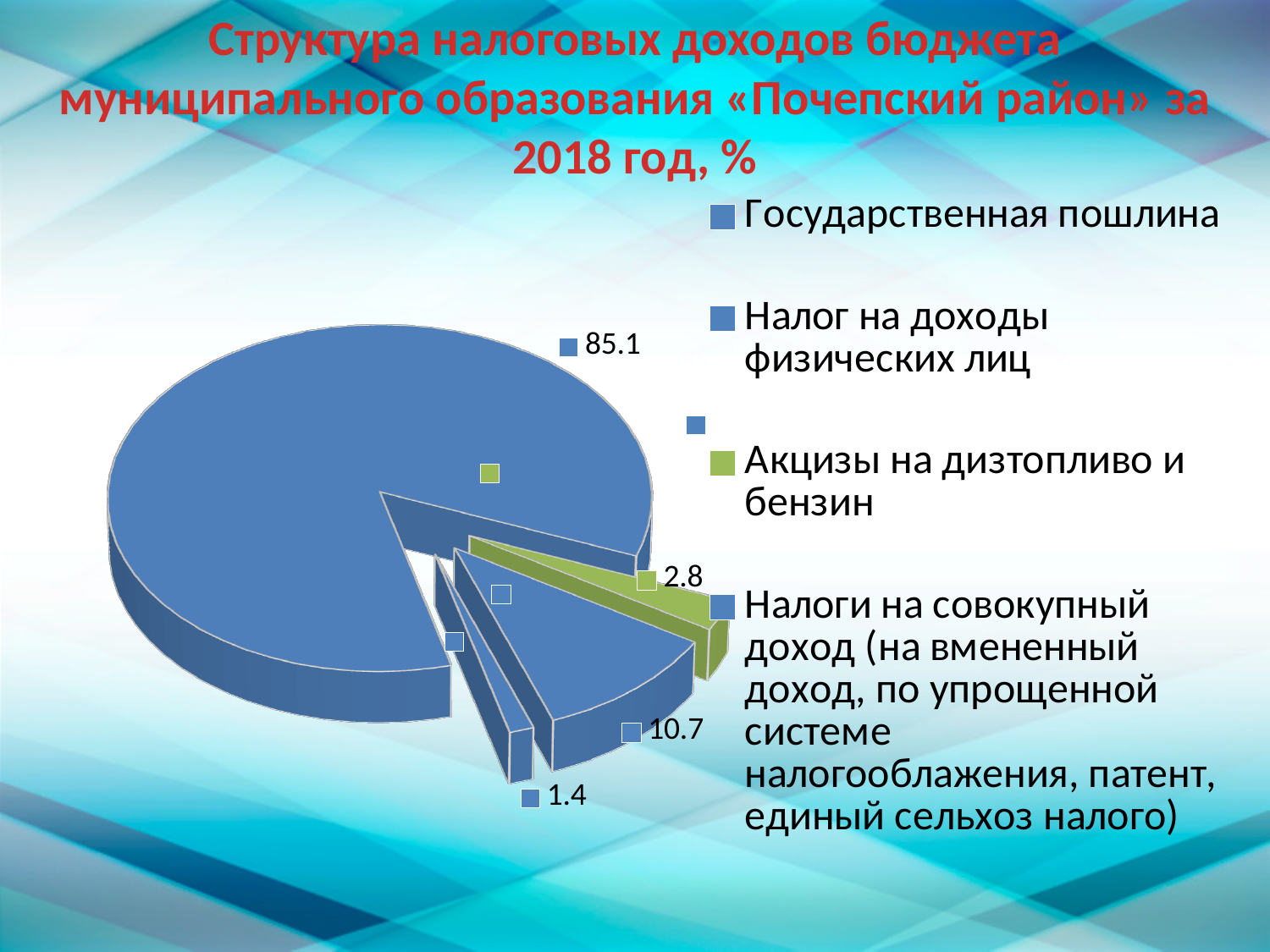
What kind of chart is shown on the slide? pie chart What is the difference between the green slice (2.8) and the smallest slice (1.4)? 1.4 How many slices with data labels does the pie chart have? 4 What share of the pie does the largest slice represent? 85.1% What is the difference between the largest slice (85.1) and the slice labelled 10.7? 74.4 What is the value of the green slice (Акцизы на дизтопливо и бензин)? 2.8 Which is larger: the slice labelled 10.7 or the green slice for Акцизы на дизтопливо и бензин? the slice labelled 10.7 What is the value of the smallest slice in the pie chart? 1.4 How many readable category names does the legend list? 4 For which year does the chart title say the tax revenue structure is shown? 2018 Which legend entry is shown in green rather than blue? Акцизы на дизтопливо и бензин What is the value of the largest slice in the pie chart? 85.1